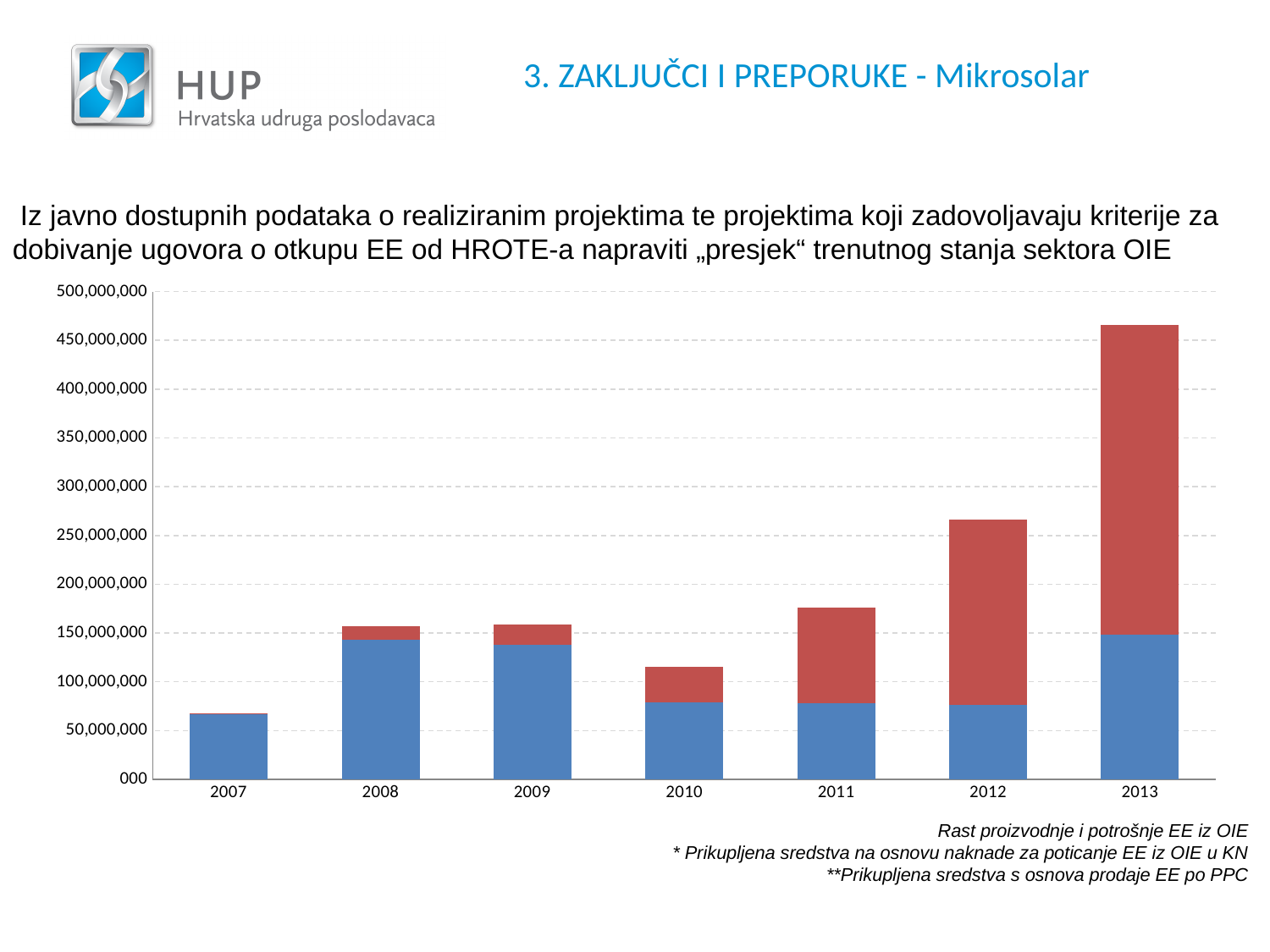
Which year has the shortest bar in the chart? 2007 Is the total value of the bar for 2012 greater or less than 250,000,000? greater What kind of chart is shown on the slide? stacked bar chart How many years are shown on the x axis of the chart? 7 Which bar is taller in total, 2012 or 2011? 2012 Is the value of the bar for 2007 greater or less than 100,000,000? less Is the total value of the bar for 2013 greater or less than 450,000,000? greater Which year has the tallest bar in the chart? 2013 Which bar is taller in total, 2008 or 2010? 2008 Which year's bar consists of only the blue segment, with no red segment? 2007